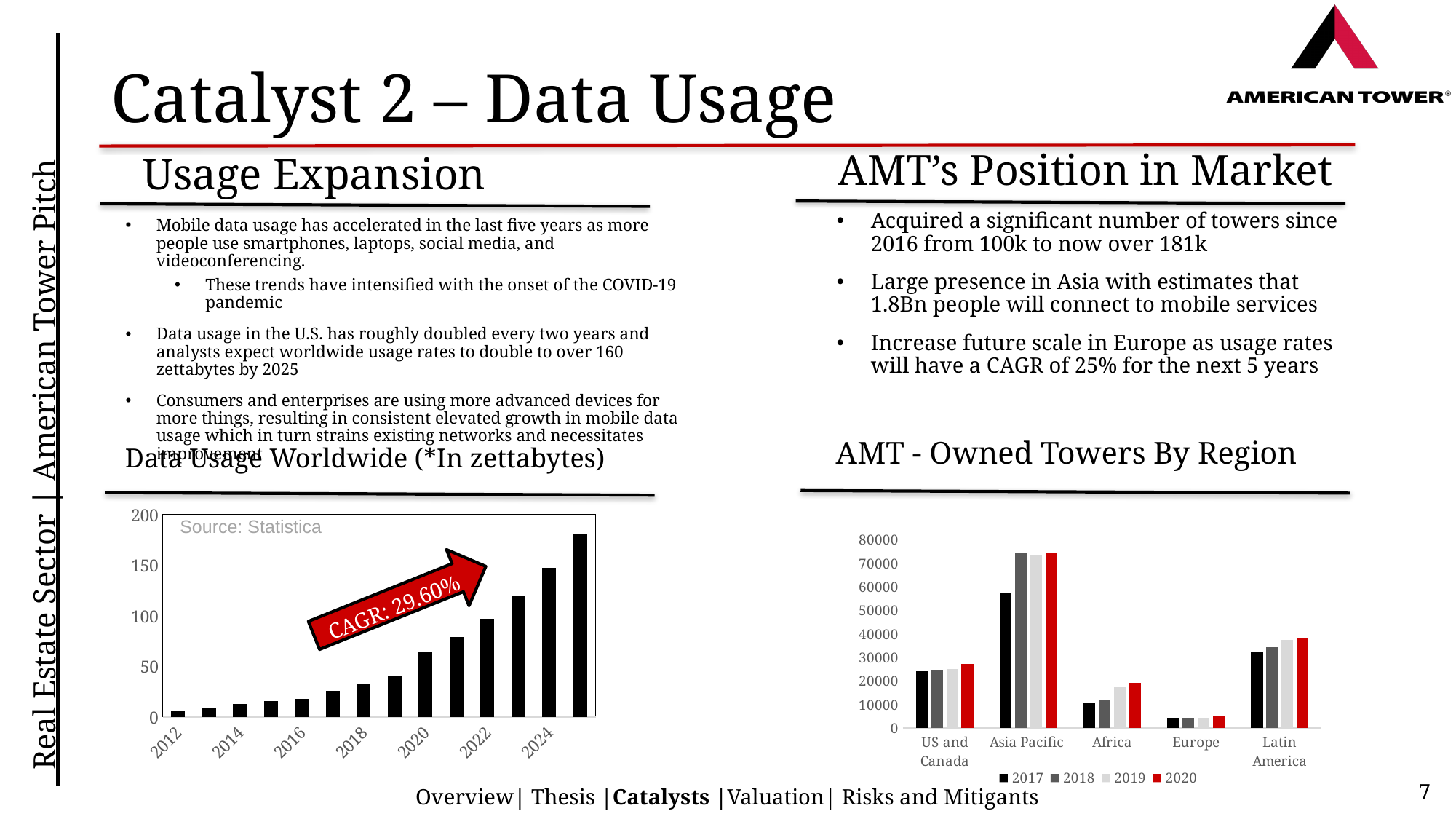
In the 'AMT - Owned Towers By Region' chart, which region has the lowest number of towers? Europe In the 'AMT - Owned Towers By Region' chart, is the 2020 value for Asia Pacific greater or less than 70000? greater In the 'Data Usage Worldwide' chart, is the value for 2024 greater or less than 100? greater How many series does the legend of the 'AMT - Owned Towers By Region' chart list? 4 What source is cited inside the 'Data Usage Worldwide' chart? Statistica How many regions are shown on the x axis of the 'AMT - Owned Towers By Region' chart? 5 In the 'AMT - Owned Towers By Region' chart, which region has the highest number of towers? Asia Pacific What CAGR is printed on the arrow in the 'Data Usage Worldwide' chart? 29.60% In the 'Data Usage Worldwide' chart, is the value for 2012 greater or less than 50? less In the 'Data Usage Worldwide' chart, do the values rise or fall from 2012 to the last year shown? rise What kind of chart is the 'Data Usage Worldwide (*In zettabytes)' chart? bar chart